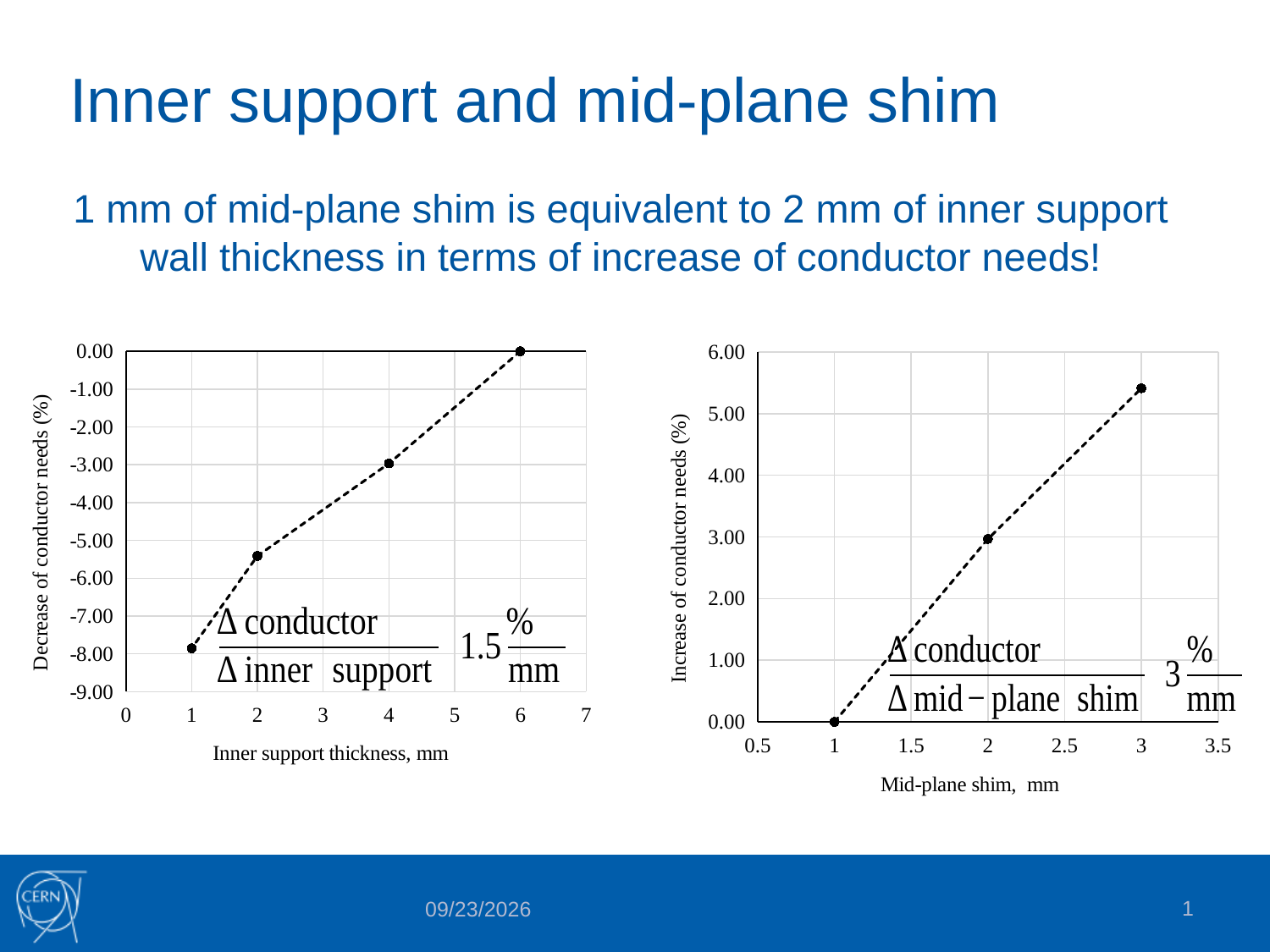
What kind of chart is the left chart, with x axis 'Inner support thickness, mm'? line chart In the left chart (Inner support thickness), is the value at 2 mm greater or less than -6.00? greater In the left chart (Inner support thickness), how many data points are plotted? 4 In the right chart (Mid-plane shim), do the values rise or fall as the mid-plane shim increases? rise In the right chart (Mid-plane shim), is the value at 3 mm greater or less than 5.00? greater In the right chart (Mid-plane shim), which mid-plane shim thickness has the highest increase of conductor needs? 3 In the right chart (Mid-plane shim), how many data points are plotted? 3 In the left chart (Inner support thickness), is the value at 1 mm greater or less than -7.00? less In the left chart (Inner support thickness), which inner support thickness has the lowest value? 1 In the left chart (Inner support thickness), what is the value at an inner support thickness of 6 mm? 0.00 In the right chart (Mid-plane shim), what is the value at a mid-plane shim of 1 mm? 0.00 What is the y-axis title of the right chart (Mid-plane shim)? Increase of conductor needs (%)